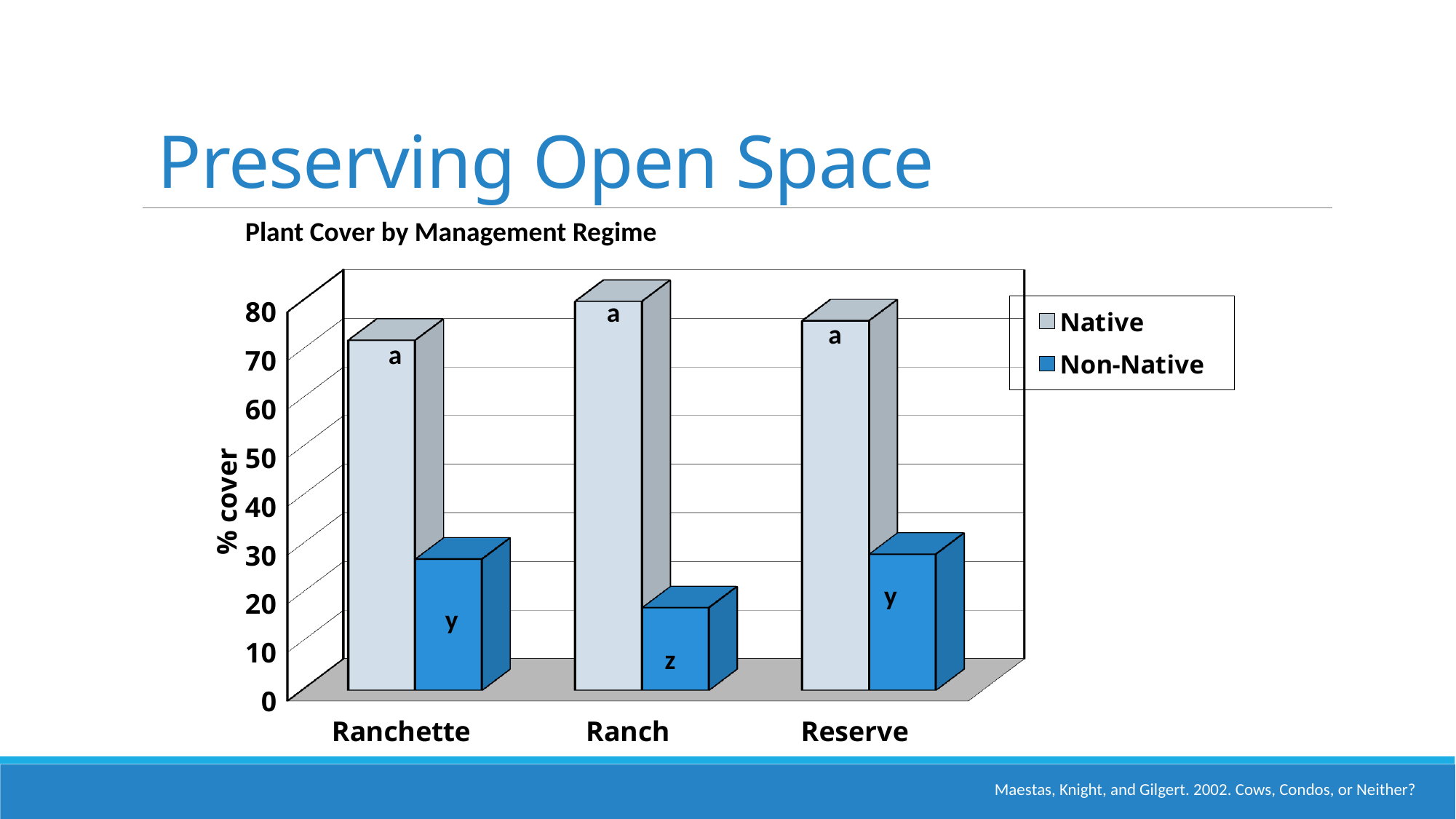
How many management regimes (categories) are shown on the x axis? 3 For Reserve, which is larger, Native cover or Non-Native cover? Native Which management regime has the lowest Non-Native plant cover? Ranch Is the Non-Native cover for Ranchette greater or less than 40? less What is the title of the chart? Plant Cover by Management Regime Is the Native cover for Ranch greater or less than 60? greater What kind of chart is shown on the slide? bar chart Which is larger, the Native cover for Ranch or the Native cover for Ranchette? Ranch What is the label on the vertical axis? % cover Is the Non-Native cover for Ranch greater or less than 30? less Which management regime has the highest Native plant cover? Ranch How many series does the legend list? 2